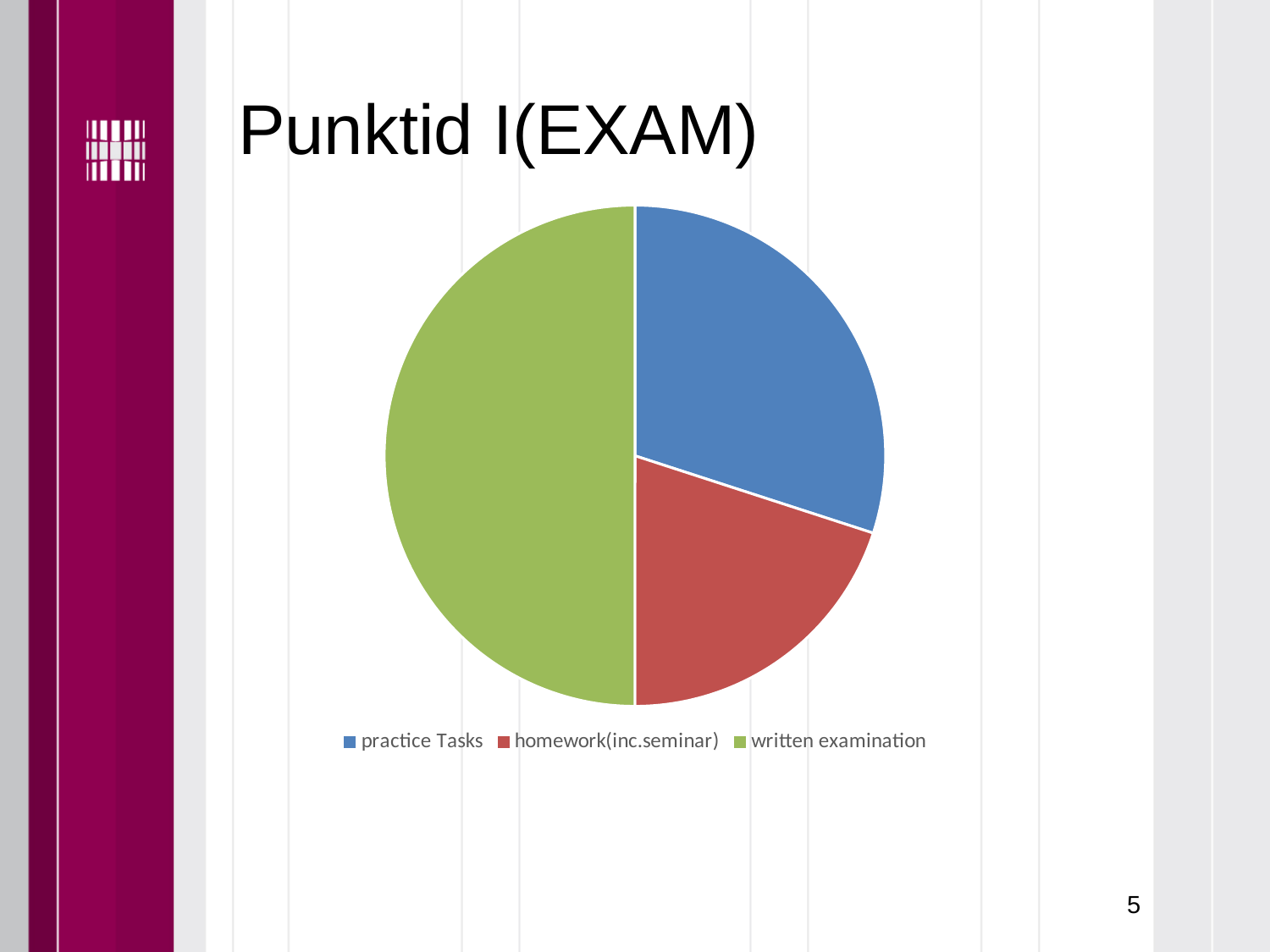
How many entries does the legend of the pie chart list? 3 Which slice is larger: homework(inc.seminar) or written examination? written examination Which category has the smallest slice of the pie chart? homework(inc.seminar) What colour is the written examination slice in the pie chart? green What kind of chart is shown on the slide? pie chart Which slice is larger: written examination or practice Tasks? written examination Which category has the largest slice of the pie chart? written examination Which slice is larger: practice Tasks or homework(inc.seminar)? practice Tasks What is the title of the slide containing the pie chart? Punktid I(EXAM) How many slices does the pie chart have? 3